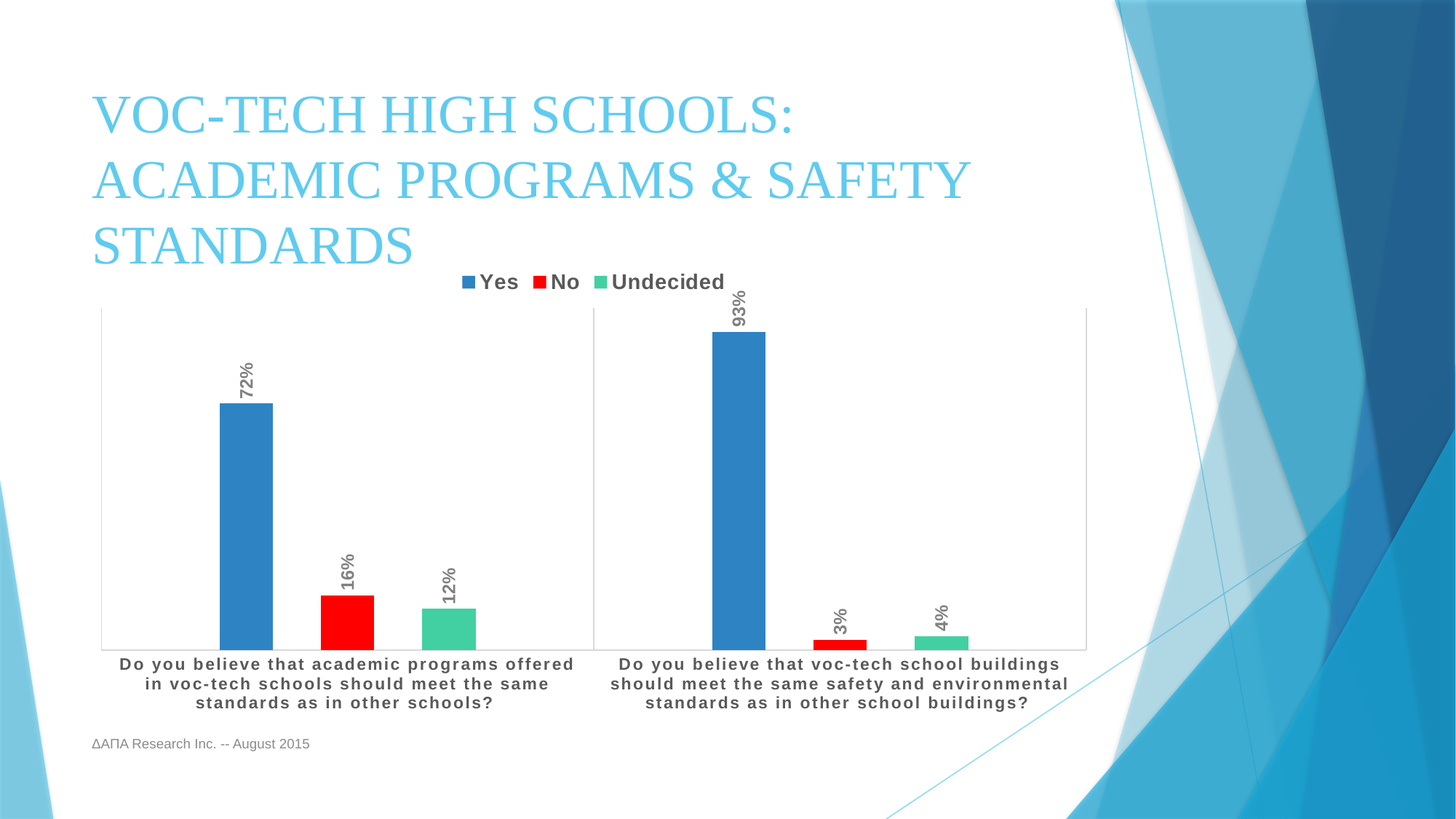
Which is larger: the No percentage for the academic programs question or the No percentage for the safety standards question? The No percentage for the academic programs question Which response was the most common for the question about voc-tech school buildings meeting the same safety and environmental standards? Yes What percentage answered No to whether voc-tech school buildings should meet the same safety and environmental standards as other school buildings? 3% How many series does the legend list? 3 What is the difference between the Yes percentages for the safety standards question and the academic programs question? 21% Which response was the least common for the question about academic programs in voc-tech schools meeting the same standards? Undecided What percentage answered Yes to whether academic programs offered in voc-tech schools should meet the same standards as in other schools? 72% What percentage answered Yes to whether voc-tech school buildings should meet the same safety and environmental standards as other school buildings? 93% How many survey questions (categories) are shown on the x axis? 2 What kind of chart is shown on the slide? Bar chart What colour represents the No responses in the chart? Red What percentage were Undecided on whether academic programs in voc-tech schools should meet the same standards as in other schools? 12%